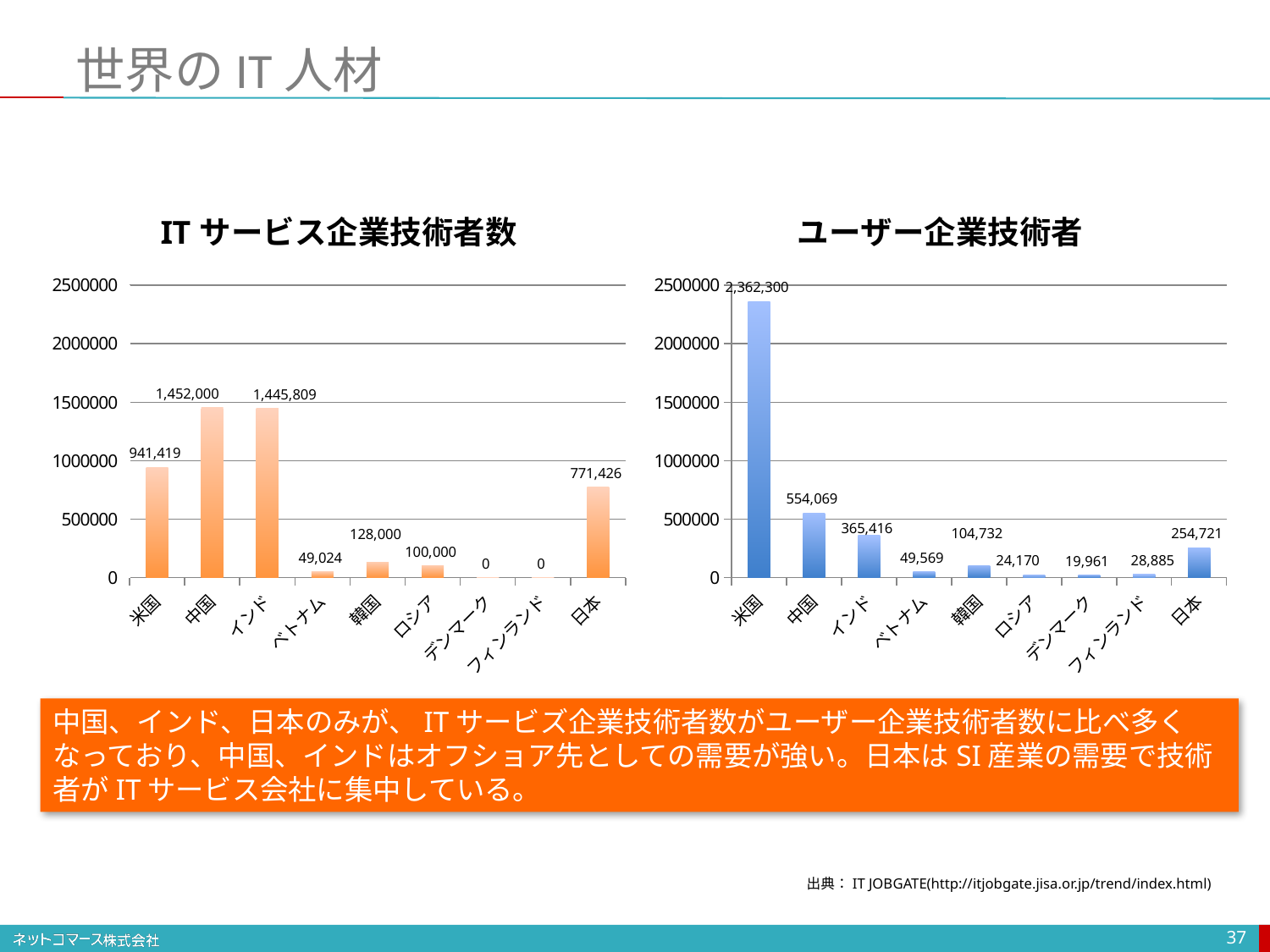
In the 'IT サービス企業技術者数' chart, what is the value for 中国? 1,452,000 In the 'ユーザー企業技術者' chart, what is the value for デンマーク? 19,961 In the 'IT サービス企業技術者数' chart, what is the value for 日本? 771,426 What is the title of the chart on the left side of the slide? IT サービス企業技術者数 In the 'ユーザー企業技術者' chart, which category has the lowest value? デンマーク How many categories are shown on the x axis of the 'IT サービス企業技術者数' chart? 9 In the 'IT サービス企業技術者数' chart, which is larger, the value for 韓国 or the value for ロシア? 韓国 What kind of chart is the 'ユーザー企業技術者' chart? bar chart In the 'ユーザー企業技術者' chart, is the value for 日本 greater or less than 500000? less In the 'IT サービス企業技術者数' chart, which category has the highest value? 中国 In the 'ユーザー企業技術者' chart, what is the value for 米国? 2,362,300 In the 'ユーザー企業技術者' chart, what is the difference between the values for 中国 and インド? 188,653